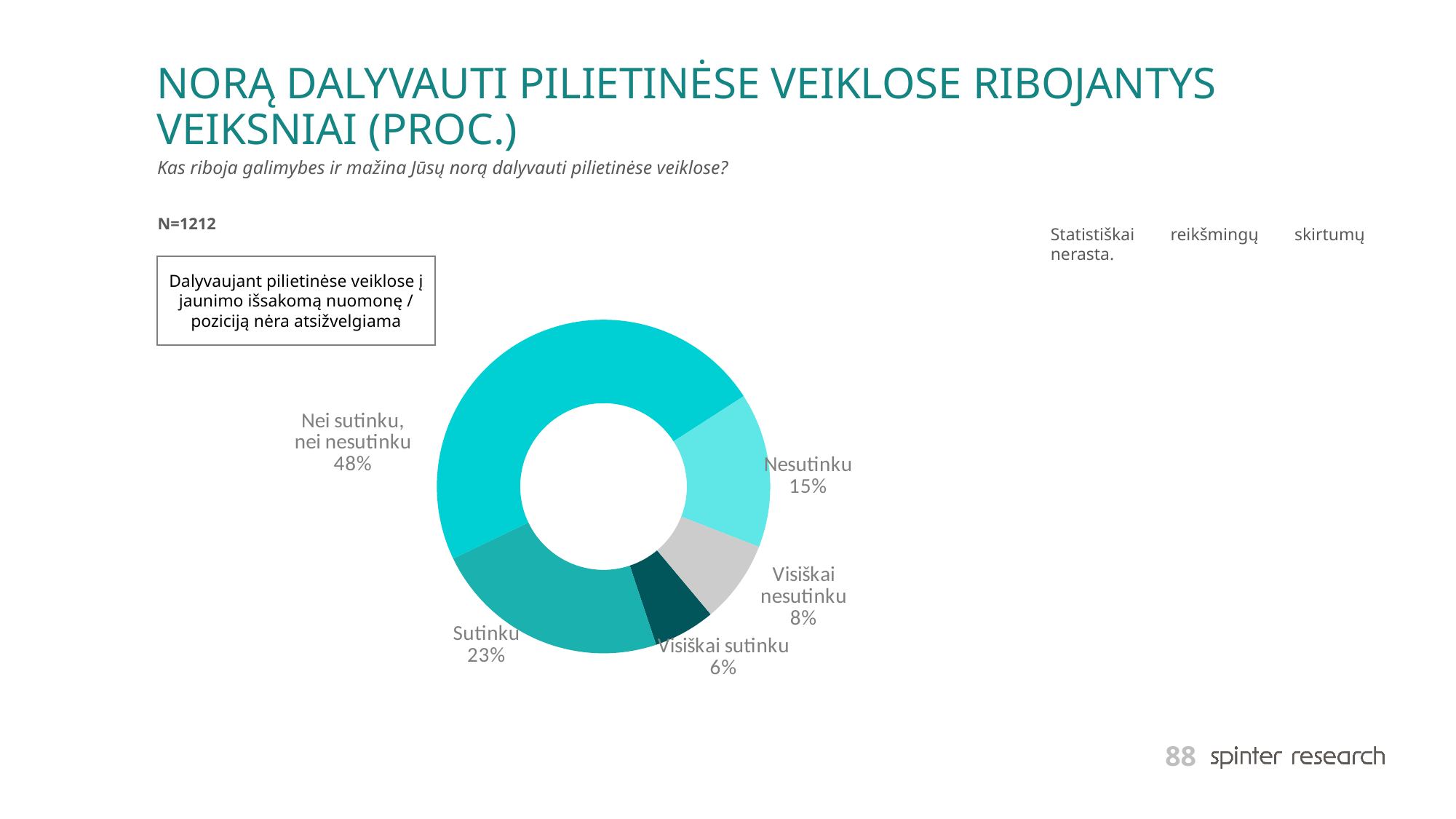
What share of respondents answered "Visiškai sutinku"? 6% What share of respondents answered "Sutinku"? 23% What kind of chart is shown on the slide? Pie chart (doughnut) How many response categories are shown in the chart? 5 What share of respondents answered "Nesutinku"? 15% Which response category has the smallest share? Visiškai sutinku What is the sample size (N) stated on the slide? N=1212 What is the difference in percentage points between "Sutinku" and "Nesutinku"? 8 What share of respondents answered "Nei sutinku, nei nesutinku"? 48% Which is larger, the share for "Visiškai nesutinku" or for "Visiškai sutinku"? Visiškai nesutinku Which response category has the largest share? Nei sutinku, nei nesutinku What share of respondents answered "Visiškai nesutinku"? 8%